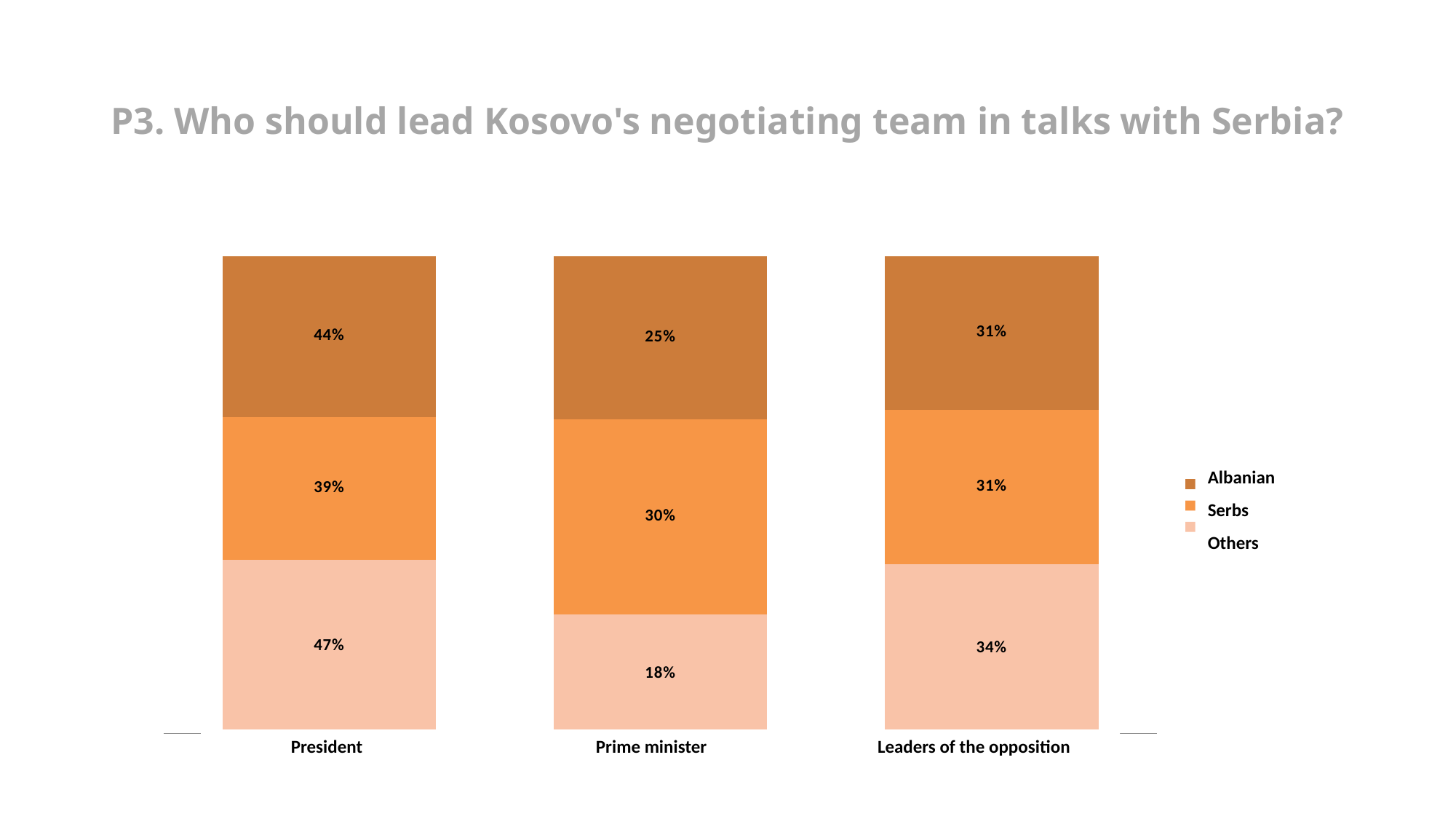
What percentage of Albanian respondents chose the President? 44% What kind of chart is shown on the slide? Stacked bar chart What is the difference between the Others percentage for President and the Others percentage for Prime minister? 29% What is the difference between the Albanian percentage for President and the Albanian percentage for Leaders of the opposition? 13% How many series does the legend list? 3 What percentage of Others chose Leaders of the opposition? 34% How many categories are shown on the x axis? 3 Which is larger: the Serbs percentage for President or the Serbs percentage for Prime minister? President What percentage of Others chose the Prime minister? 18% What percentage of Serb respondents chose the Prime minister? 30% Among Others, which option received the lowest percentage? Prime minister Among Albanian respondents, which option received the highest percentage? President